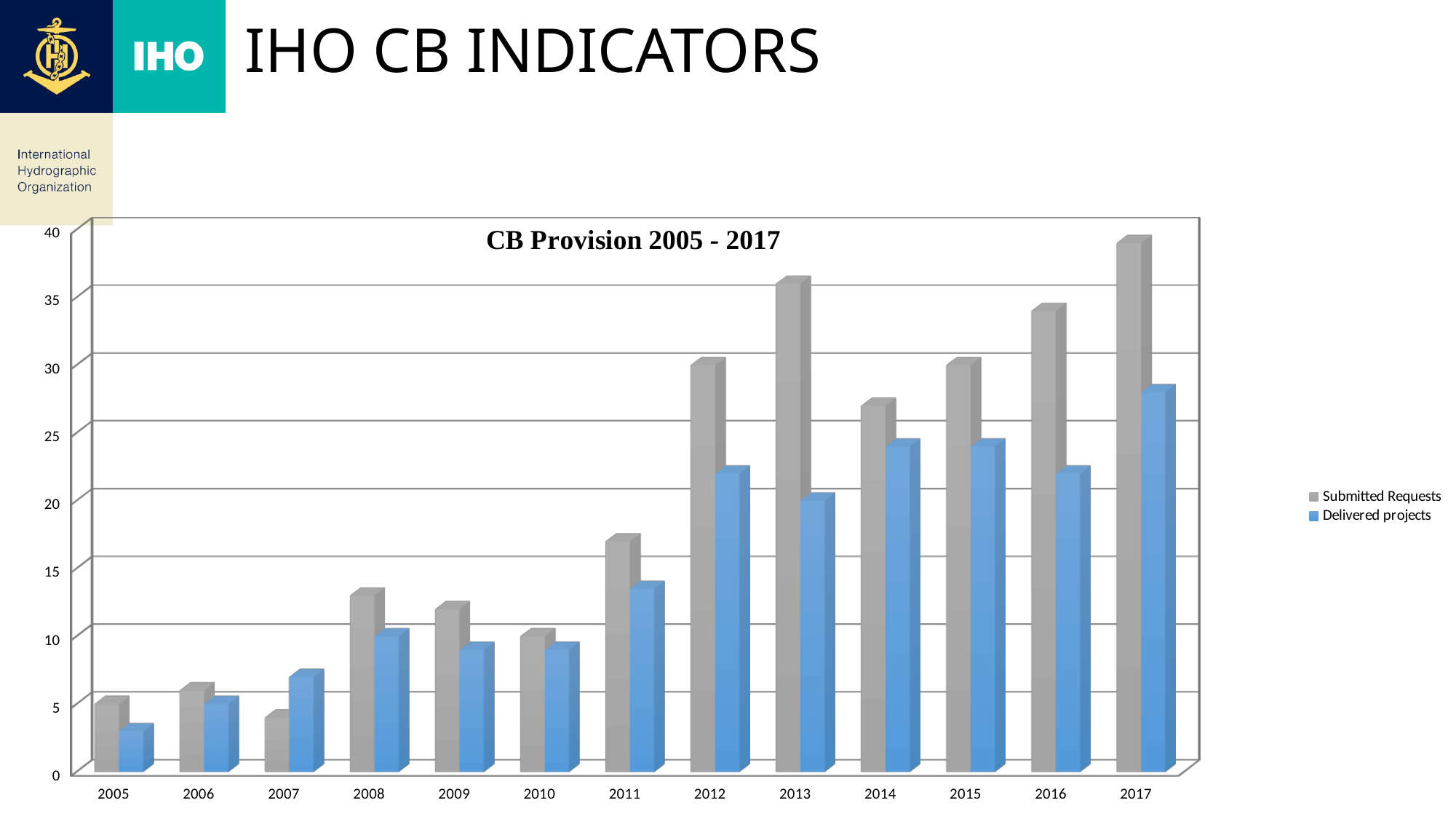
Which is larger, Submitted Requests in 2013 or Submitted Requests in 2014? 2013 In 2007, which is larger, Submitted Requests or Delivered projects? Delivered projects Which year has the highest value for Delivered projects? 2017 Is the value for Delivered projects in 2017 greater or less than 25? greater How many years are shown on the x axis of the chart? 13 What type of chart is shown on the slide? bar chart Which year has the highest value for Submitted Requests? 2017 How many series does the legend list? 2 Is the value for Submitted Requests in 2013 greater or less than 30? greater What is the title of the chart? CB Provision 2005 - 2017 Overall, do Submitted Requests rise or fall from 2005 to 2017? rise Which year has the lowest value for Delivered projects? 2005